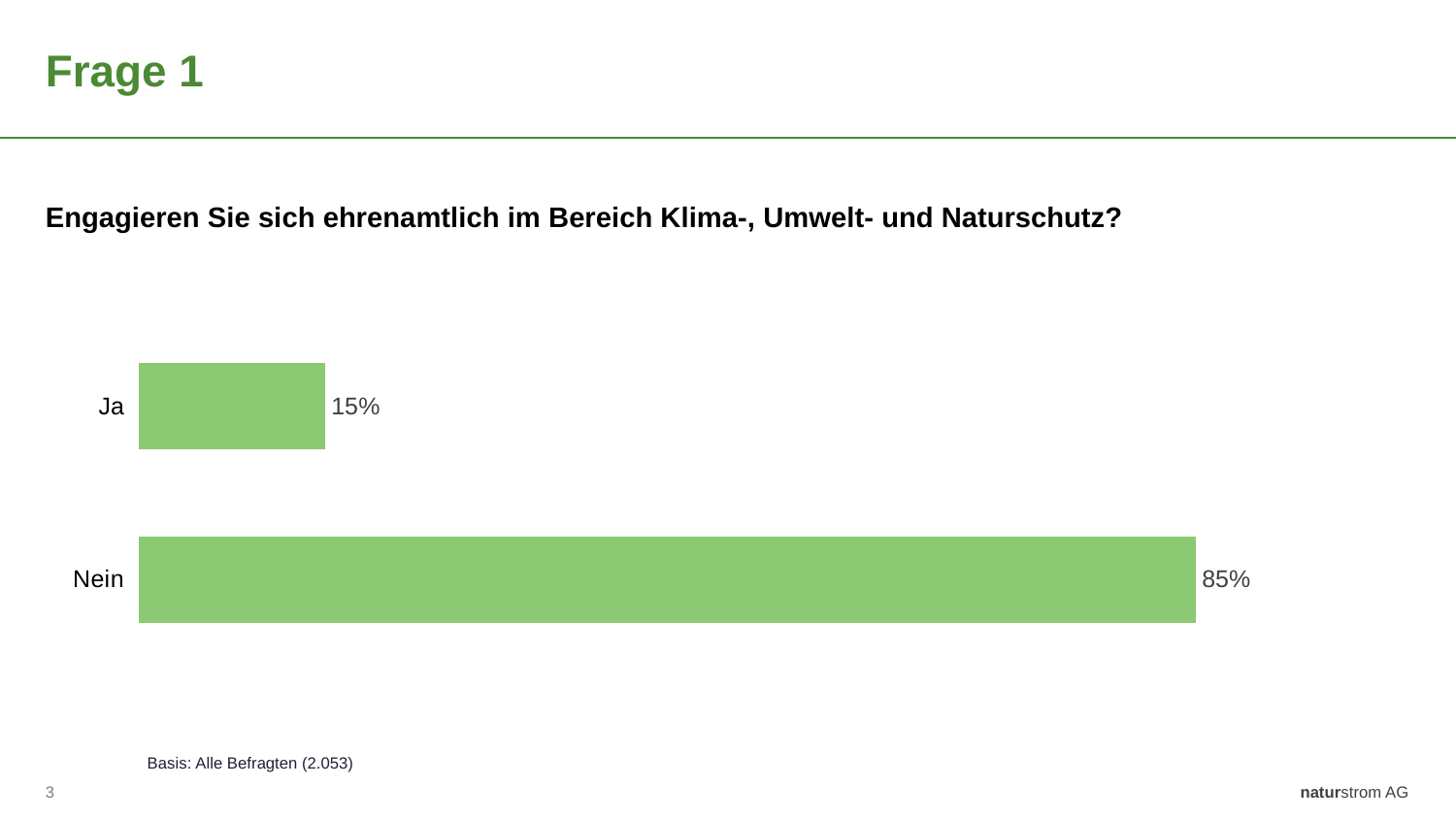
Which category has the highest value? Nein Which category has the lowest value? Ja What is the value for "Ja"? 15% How many categories are shown in the chart? 2 What is the difference between the values for "Nein" and "Ja"? 70% What question does the chart on the slide answer? Engagieren Sie sich ehrenamtlich im Bereich Klima-, Umwelt- und Naturschutz? What is the value for "Nein"? 85% What is the basis (number of respondents) stated below the chart? Alle Befragten (2.053) What kind of chart is shown on the slide? Bar chart Which is larger, the value for "Ja" or the value for "Nein"? Nein What is the total of the values for "Ja" and "Nein"? 100%